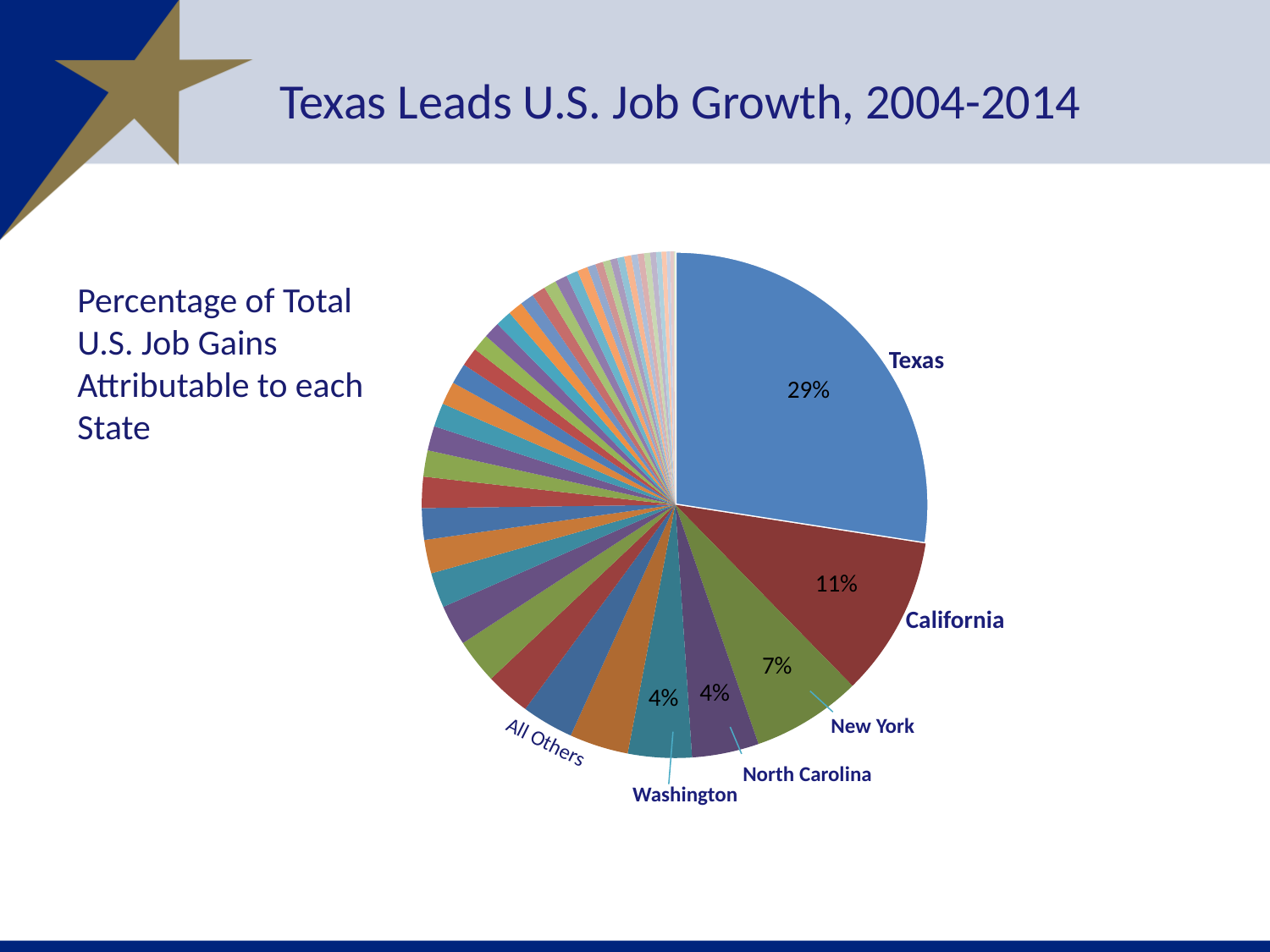
Which state has the largest share of the pie? Texas What percentage of total U.S. job gains is attributable to North Carolina? 4% What is the difference in percentage points between Texas's share and California's share? 18 What type of chart is shown on the slide? pie chart What is the title of the slide containing the pie chart? Texas Leads U.S. Job Growth, 2004-2014 Which has a larger share of U.S. job gains, California or New York? California What label is given to the group of many small slices on the left side of the pie? All Others What percentage of total U.S. job gains is attributable to New York? 7% What percentage of total U.S. job gains is attributable to Washington? 4% What percentage of total U.S. job gains is attributable to California? 11% What is the difference in percentage points between California's share and New York's share? 4 What percentage of total U.S. job gains is attributable to Texas? 29%